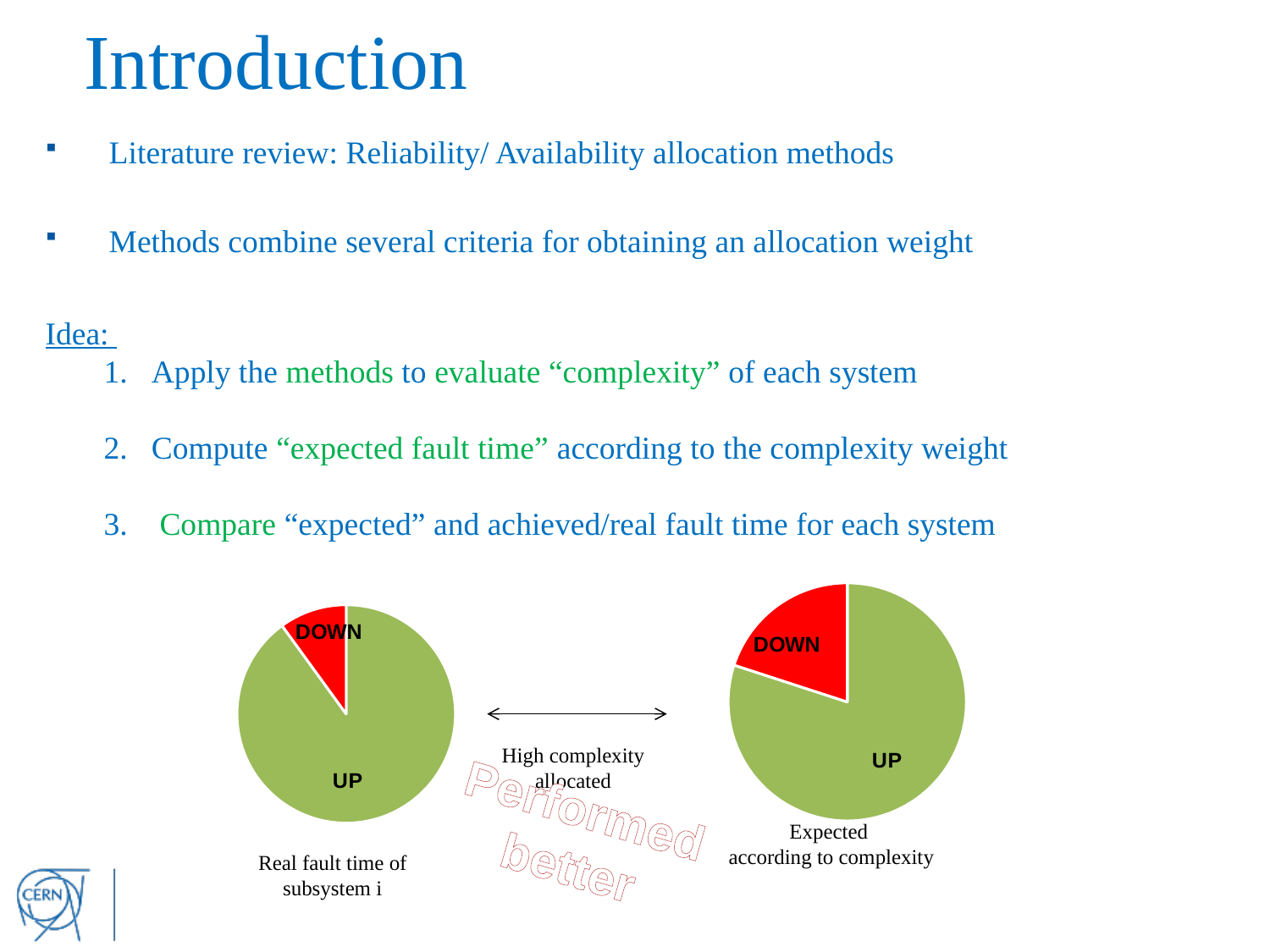
Is the DOWN slice larger in the left pie chart ("Real fault time of subsystem i") or in the right pie chart ("Expected according to complexity")? right pie chart (Expected according to complexity) In the left pie chart ("Real fault time of subsystem i"), which slice is the largest? UP In the left pie chart ("Real fault time of subsystem i"), which slice is the smallest? DOWN What kind of chart is the left chart, captioned "Real fault time of subsystem i"? pie chart What kind of chart is the right chart, captioned "Expected according to complexity"? pie chart In the right pie chart ("Expected according to complexity"), which slice is the smallest? DOWN In the right pie chart ("Expected according to complexity"), how many slices are there? 2 In the left pie chart ("Real fault time of subsystem i"), how many slices are there? 2 In the right pie chart ("Expected according to complexity"), is the UP slice larger or smaller than the DOWN slice? larger What colour is the UP slice in the right pie chart ("Expected according to complexity")? green In the right pie chart ("Expected according to complexity"), which slice is the largest? UP What colour is the DOWN slice in the left pie chart ("Real fault time of subsystem i")? red